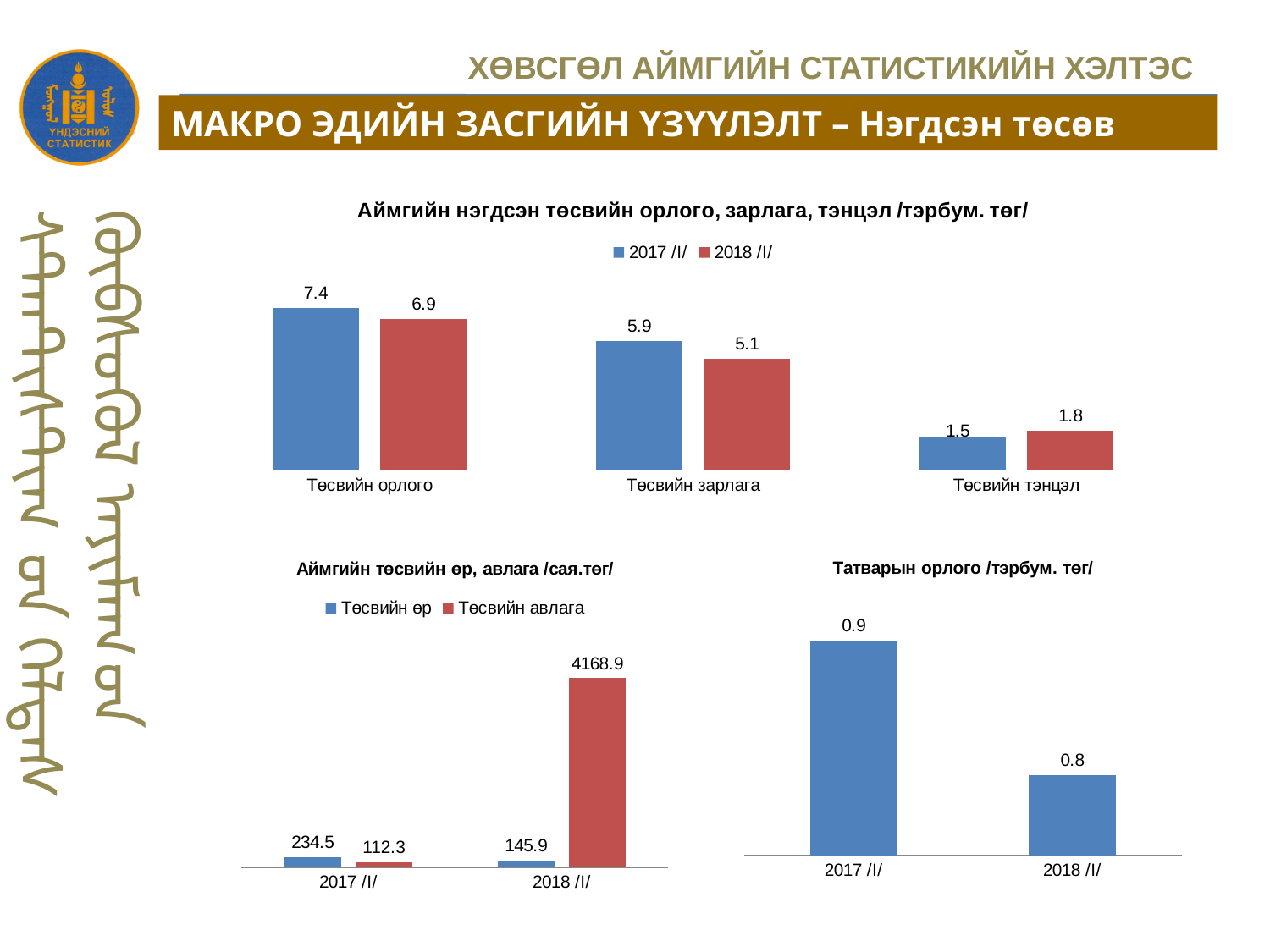
What type of chart is the bottom-right chart 'Татварын орлого'? Bar chart In the bottom-left chart 'Аймгийн төсвийн өр, авлага', what is the value of Төсвийн өр for 2017 /I/? 234.5 In the top chart 'Аймгийн нэгдсэн төсвийн орлого, зарлага, тэнцэл', what is the value for Төсвийн орлого in 2017 /I/? 7.4 In the bottom-left chart 'Аймгийн төсвийн өр, авлага', what is the difference between Төсвийн өр in 2017 /I/ and 2018 /I/? 88.6 How many series does the legend of the top chart 'Аймгийн нэгдсэн төсвийн орлого, зарлага, тэнцэл' list? 2 How many categories are shown on the x axis of the top chart 'Аймгийн нэгдсэн төсвийн орлого, зарлага, тэнцэл'? 3 In the bottom-left chart 'Аймгийн төсвийн өр, авлага', what is the value of Төсвийн авлага for 2018 /I/? 4168.9 In the top chart 'Аймгийн нэгдсэн төсвийн орлого, зарлага, тэнцэл', what is the difference between the 2017 /I/ and 2018 /I/ values for Төсвийн зарлага? 0.8 In the top chart 'Аймгийн нэгдсэн төсвийн орлого, зарлага, тэнцэл', which category has the lowest value for 2017 /I/? Төсвийн тэнцэл In the top chart 'Аймгийн нэгдсэн төсвийн орлого, зарлага, тэнцэл', what is the value for Төсвийн зарлага in 2018 /I/? 5.1 In the bottom-right chart 'Татварын орлого', what is the value for 2018 /I/? 0.8 In the top chart 'Аймгийн нэгдсэн төсвийн орлого, зарлага, тэнцэл', which is larger for Төсвийн тэнцэл: 2017 /I/ or 2018 /I/? 2018 /I/